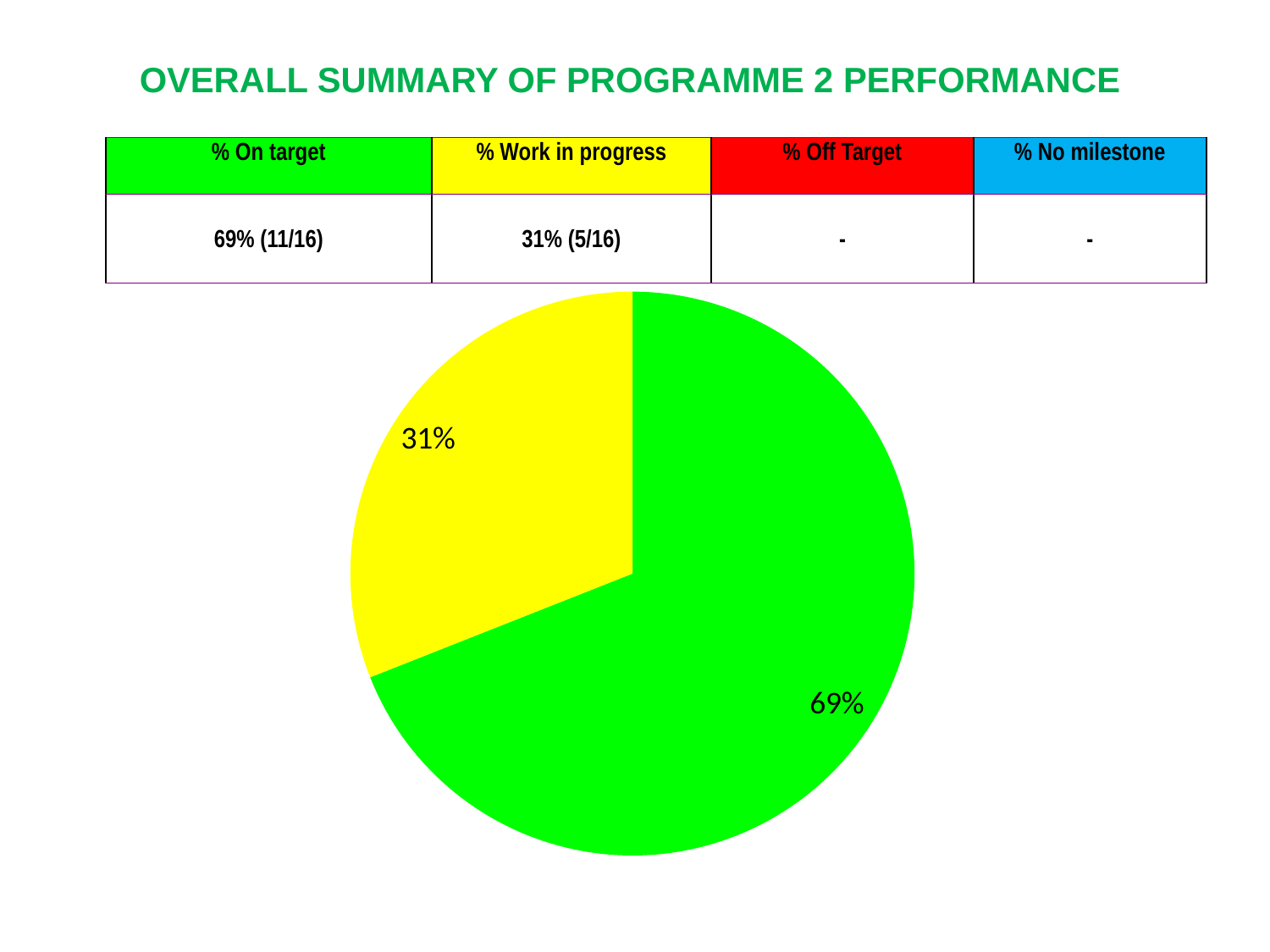
Which slice of the pie chart is the largest? the green slice (69%) According to the table above the pie chart, what status does the yellow colour represent? % Work in progress What percentage is shown on the green slice of the pie chart? 69% According to the table above the pie chart, what status does the green colour represent? % On target Is the value of the green slice of the pie chart greater or less than 50%? greater Which slice of the pie chart is the smallest? the yellow slice (31%) Is the green slice or the yellow slice of the pie chart larger? the green slice How many slices does the pie chart have? 2 What kind of chart is shown on the slide? pie chart What share of the pie does the yellow slice represent? 31% What is the difference in percentage points between the green slice and the yellow slice of the pie chart? 38 What percentage is shown on the yellow slice of the pie chart? 31%